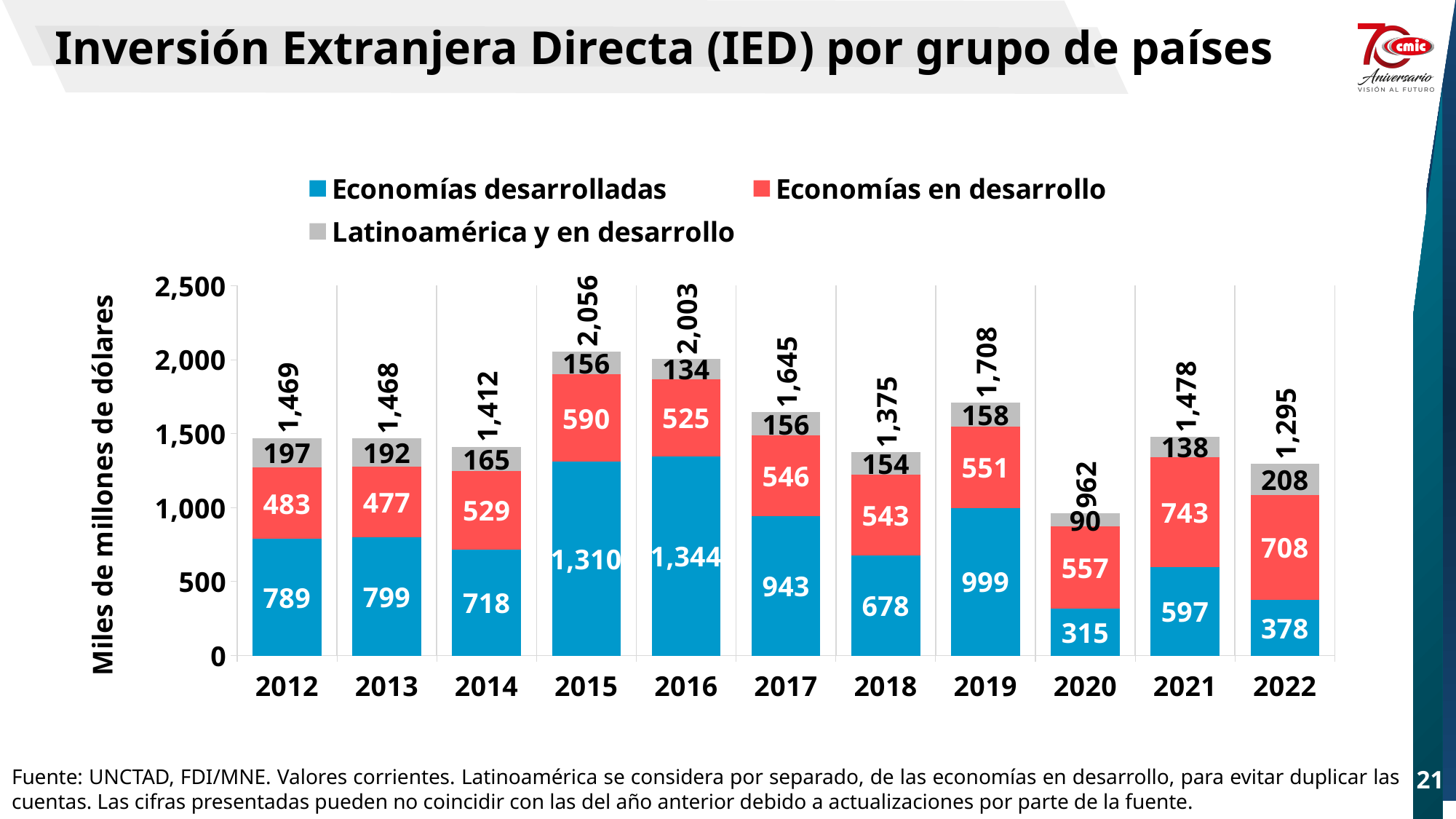
What kind of chart is shown? Stacked bar chart How many series does the legend list? 3 What is the value for Economías en desarrollo in 2021? 743 How many years are shown on the x axis? 11 What is the value for Latinoamérica y en desarrollo in 2022? 208 What is the value for Economías desarrolladas in 2016? 1,344 What is the label of the y axis? Miles de millones de dólares Which year has the highest value for Economías desarrolladas? 2016 Which is larger, the Economías en desarrollo value in 2014 or in 2017? 2017 What is the difference between the Economías desarrolladas values for 2019 and 2020? 684 What is the total of the stacked bar for 2015? 2,056 Which year has the lowest total? 2020